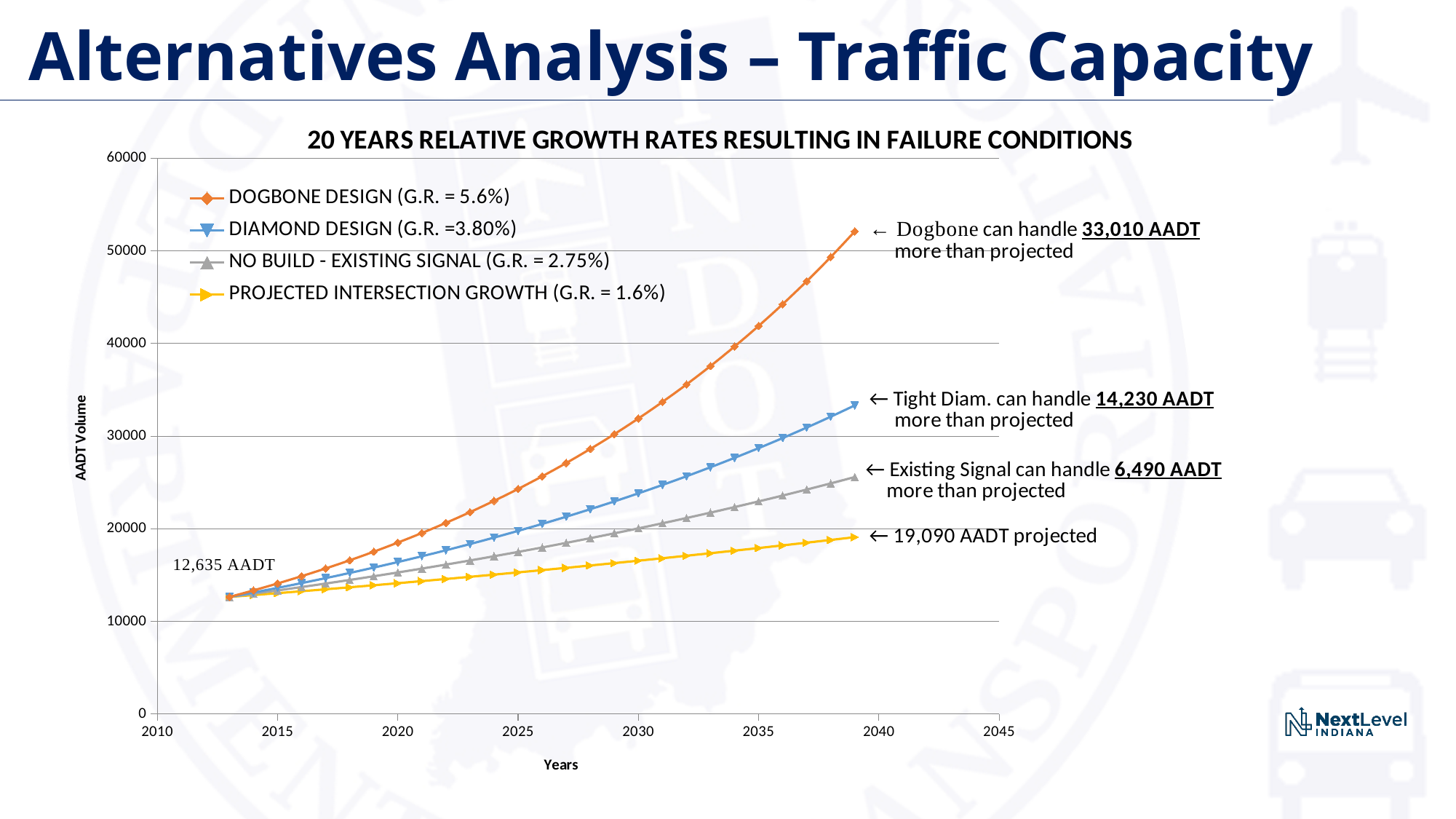
Is the DOGBONE DESIGN value in 2039 greater or less than 50000? greater Which series reaches the highest AADT volume by 2039? DOGBONE DESIGN (G.R. = 5.6%) What AADT value is labelled as projected at the end of the PROJECTED INTERSECTION GROWTH line? 19,090 AADT What AADT value is labelled at the start of the lines in 2013? 12,635 AADT What growth rate does the legend give for the DOGBONE DESIGN series? 5.6% What type of chart is shown on the slide? Line chart Which series has the lowest AADT volume by 2039? PROJECTED INTERSECTION GROWTH (G.R. = 1.6%) According to the chart annotation, how much more AADT than projected can the Existing Signal handle? 6,490 AADT How many series does the chart legend list? 4 What is the title of the chart? 20 YEARS RELATIVE GROWTH RATES RESULTING IN FAILURE CONDITIONS Do the AADT volumes rise or fall along the x axis from 2013 to 2039? Rise According to the chart annotation, how much more AADT than projected can the Dogbone design handle? 33,010 AADT